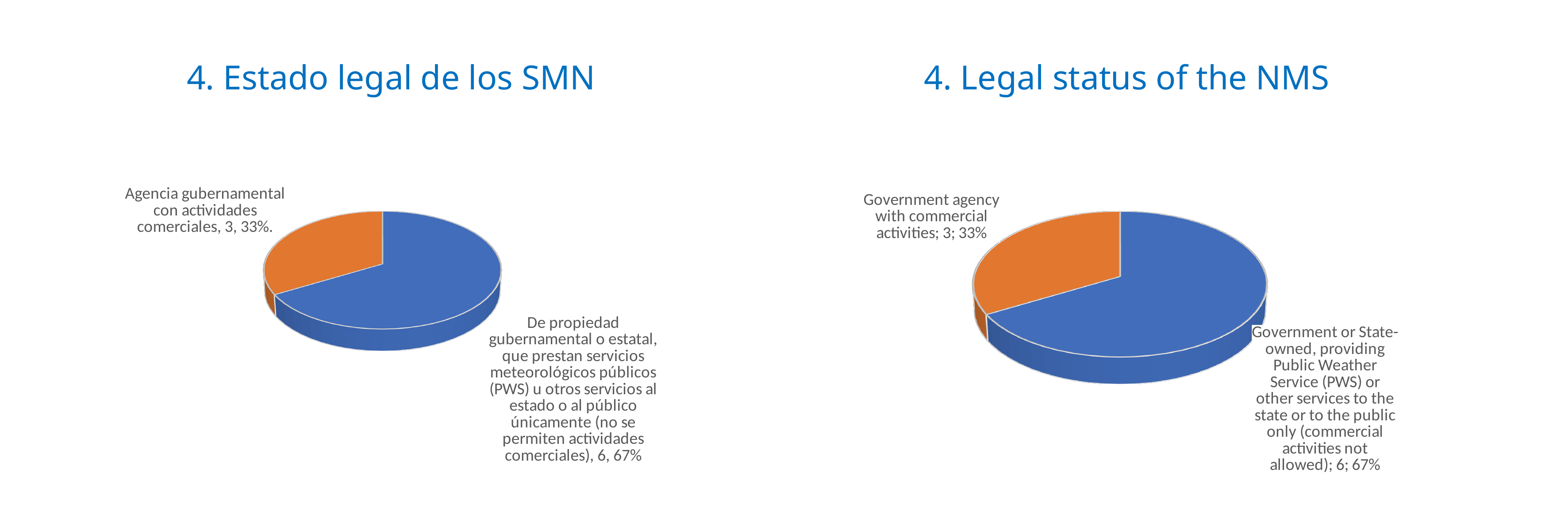
In the chart titled '4. Legal status of the NMS', how many slices does the pie have? 2 In the chart titled '4. Legal status of the NMS', what is the total count across both slices? 9 In the chart titled '4. Legal status of the NMS', what colour is the 'Government agency with commercial activities' slice? orange In the chart titled '4. Estado legal de los SMN', which category has the smallest slice? Agencia gubernamental con actividades comerciales In the chart titled '4. Estado legal de los SMN', what is the count for 'Agencia gubernamental con actividades comerciales'? 3 In the chart titled '4. Legal status of the NMS', what share of the pie is the 'Government or State-owned' slice? 67% In the chart titled '4. Legal status of the NMS', what share of the pie is 'Government agency with commercial activities'? 33% In the chart titled '4. Legal status of the NMS', what kind of chart is shown? pie chart In the chart titled '4. Estado legal de los SMN', what share of the pie is the 'De propiedad gubernamental o estatal' slice? 67% In the chart titled '4. Legal status of the NMS', which category has the largest slice? Government or State-owned, providing Public Weather Service (PWS) or other services to the state or to the public only (commercial activities not allowed) In the chart titled '4. Legal status of the NMS', what is the count for 'Government agency with commercial activities'? 3 In the chart titled '4. Legal status of the NMS', what is the difference in count between the 'Government or State-owned' slice and the 'Government agency with commercial activities' slice? 3